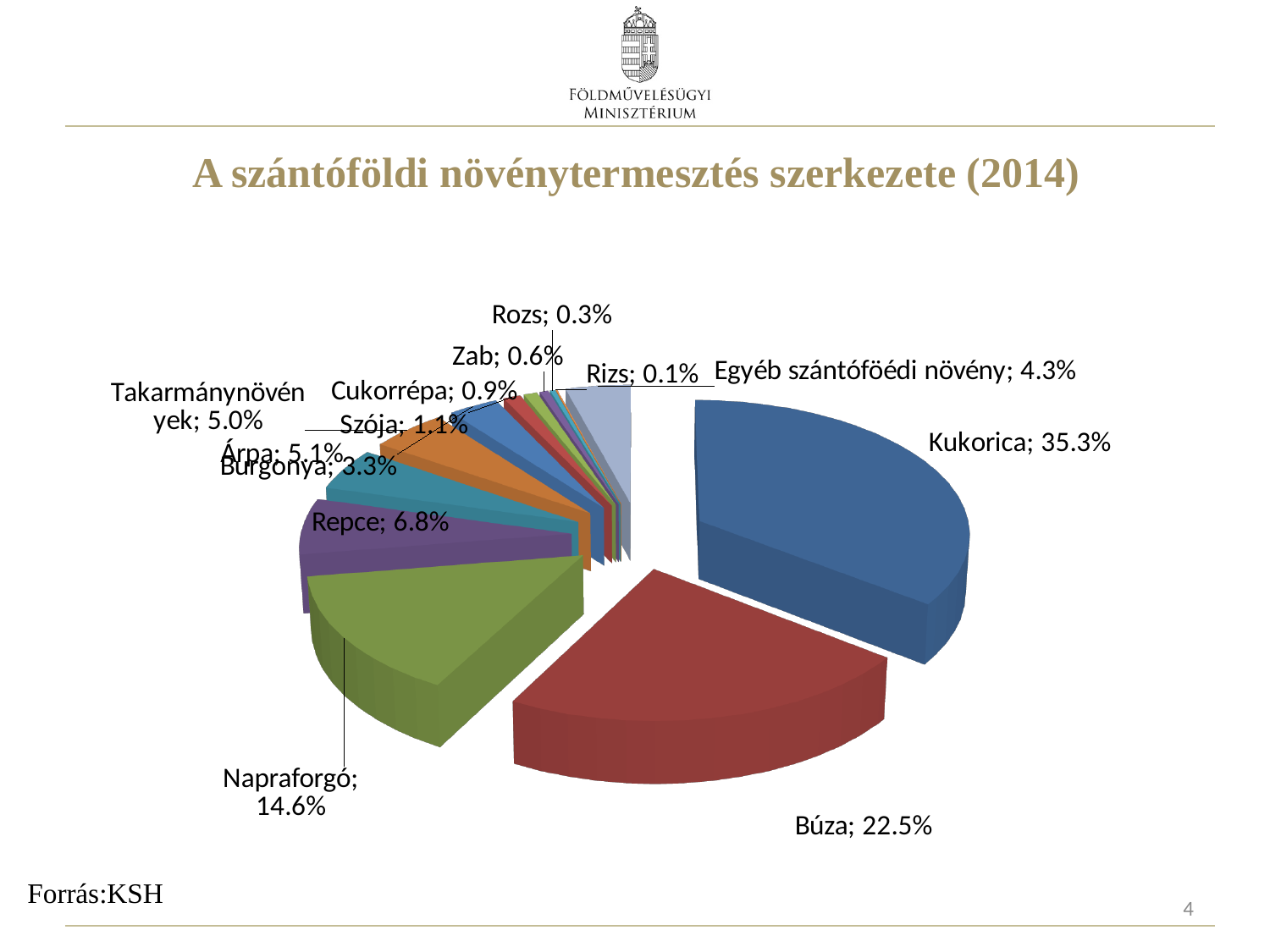
What is the value for Repce? 6.8% What is the difference in percentage points between Kukorica and Búza? 12.8 What percentage is shown for Napraforgó? 14.6% What is the value shown for Búza? 22.5% Which category has the smallest slice of the pie? Rizs Which is larger, the share for Repce or the share for Takarmánynövények? Repce What share of the pie does Kukorica have? 35.3% What kind of chart is shown on the slide? Pie chart What is the title of the chart on the slide? A szántóföldi növénytermesztés szerkezete (2014) What share is shown for Egyéb szántóföldi növény? 4.3% Which category has the largest slice of the pie? Kukorica How many categories are shown in the pie chart? 13